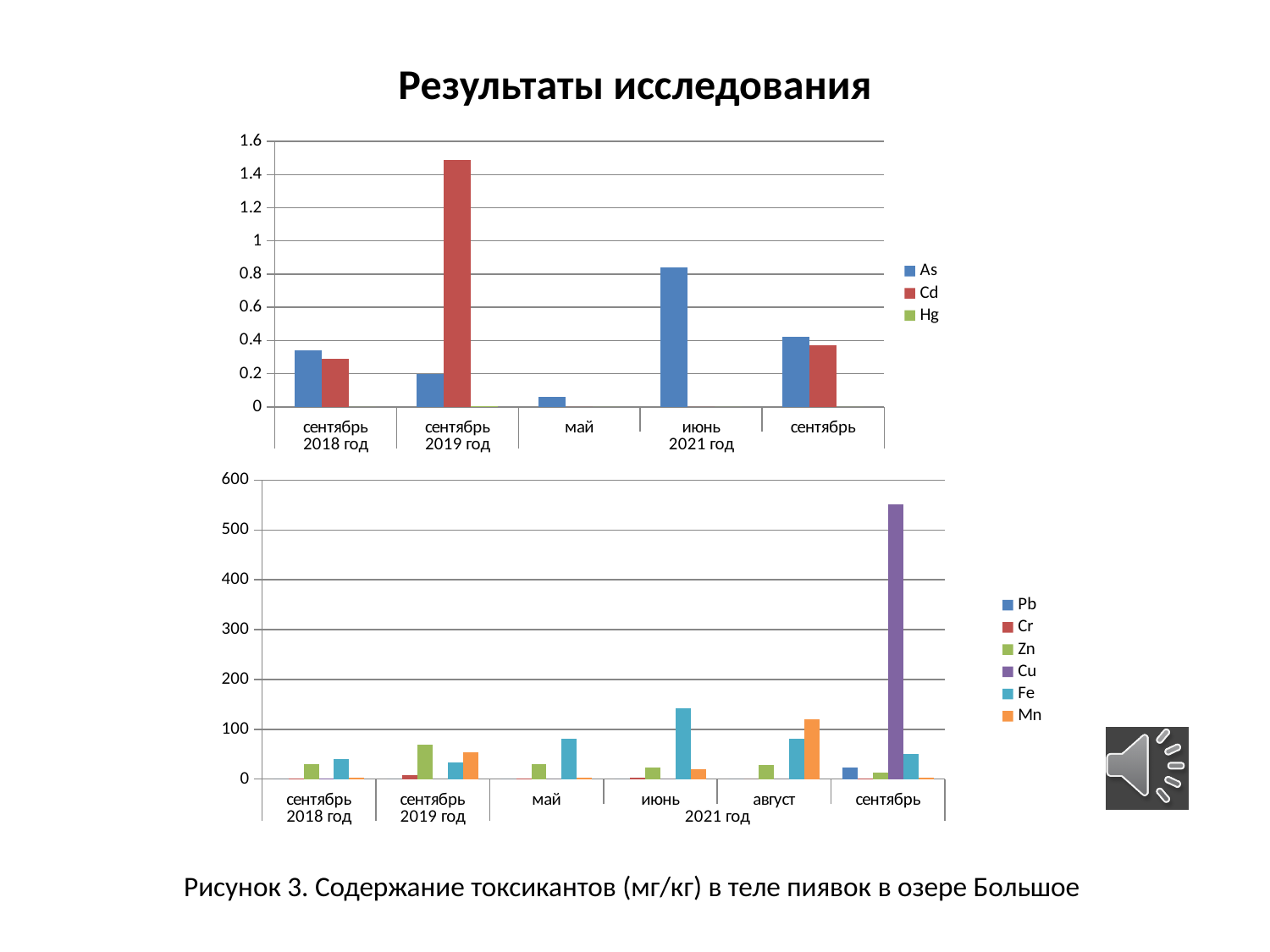
How many series does the legend of the top chart list? 3 In the top chart, is the value for Cd in сентябрь 2019 год greater or less than 1.4? greater How many series does the legend of the bottom chart list? 6 In the bottom chart, which series is shown in purple? Cu How many categories are shown on the x axis of the top chart? 5 In the top chart, which series has the tallest bar overall? Cd What kind of chart is the top chart on the slide? bar chart In the bottom chart, which series has the tallest bar overall? Cu In the bottom chart, is the value for Cu in сентябрь 2021 год greater or less than 500? greater In the bottom chart, is the value for Fe in июнь 2021 год greater or less than 100? greater In the top chart, which is larger in сентябрь 2018 год: As or Cd? As How many categories are shown on the x axis of the bottom chart? 6